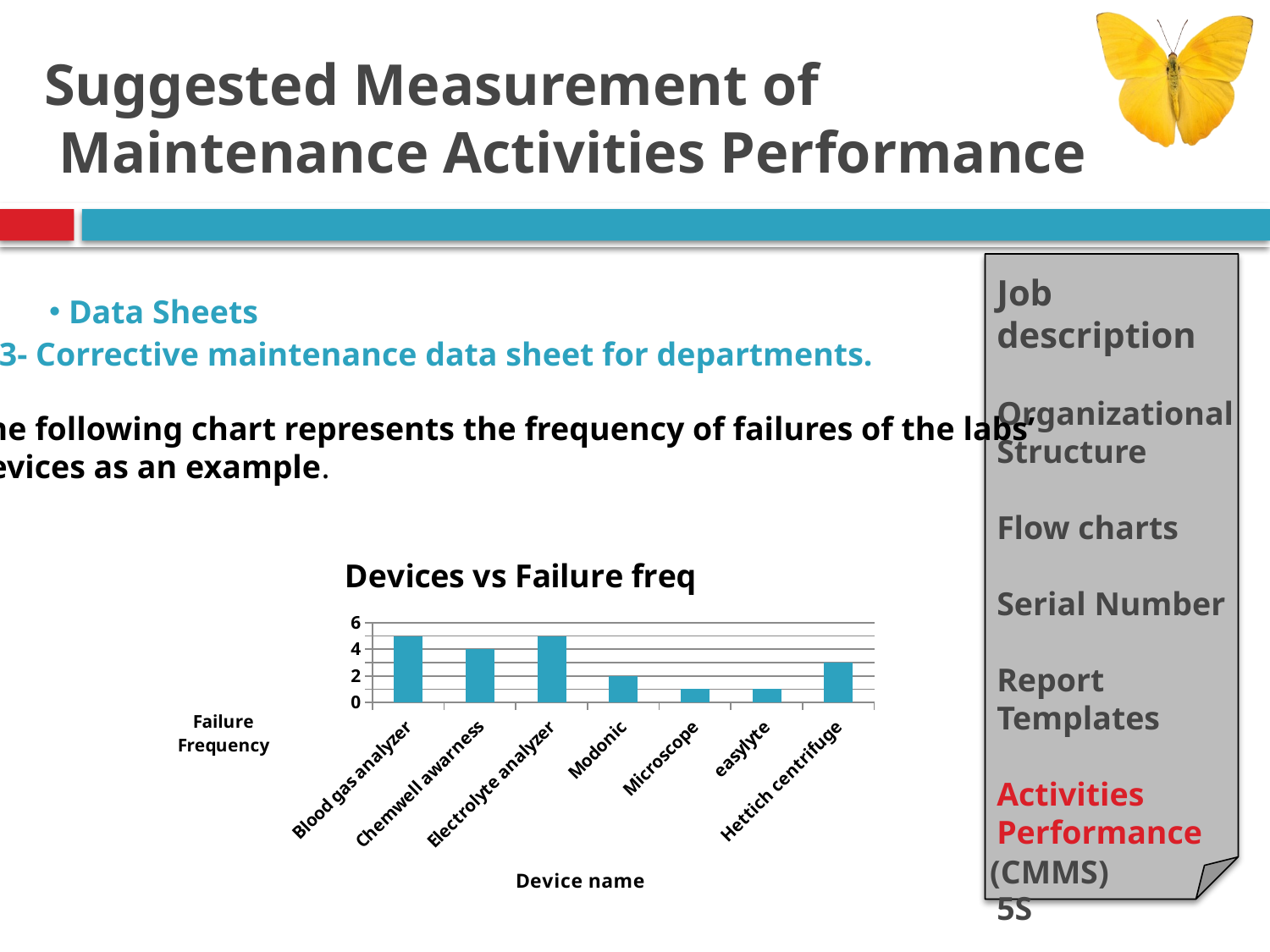
Is the value for Electrolyte analyzer greater or less than 4? greater What is the label of the x axis of the chart? Device name Which has a higher failure frequency, Hettich centrifuge or easylyte? Hettich centrifuge What is the failure frequency for Modonic? 2 Which has a higher failure frequency, Blood gas analyzer or Modonic? Blood gas analyzer What is the title of the chart? Devices vs Failure freq What is the failure frequency for Chemwell awarness? 4 Is the value for Microscope greater or less than 2? less Is the value for Blood gas analyzer greater or less than 4? greater What type of chart is shown on the slide? bar chart How many devices are shown on the x axis of the chart? 7